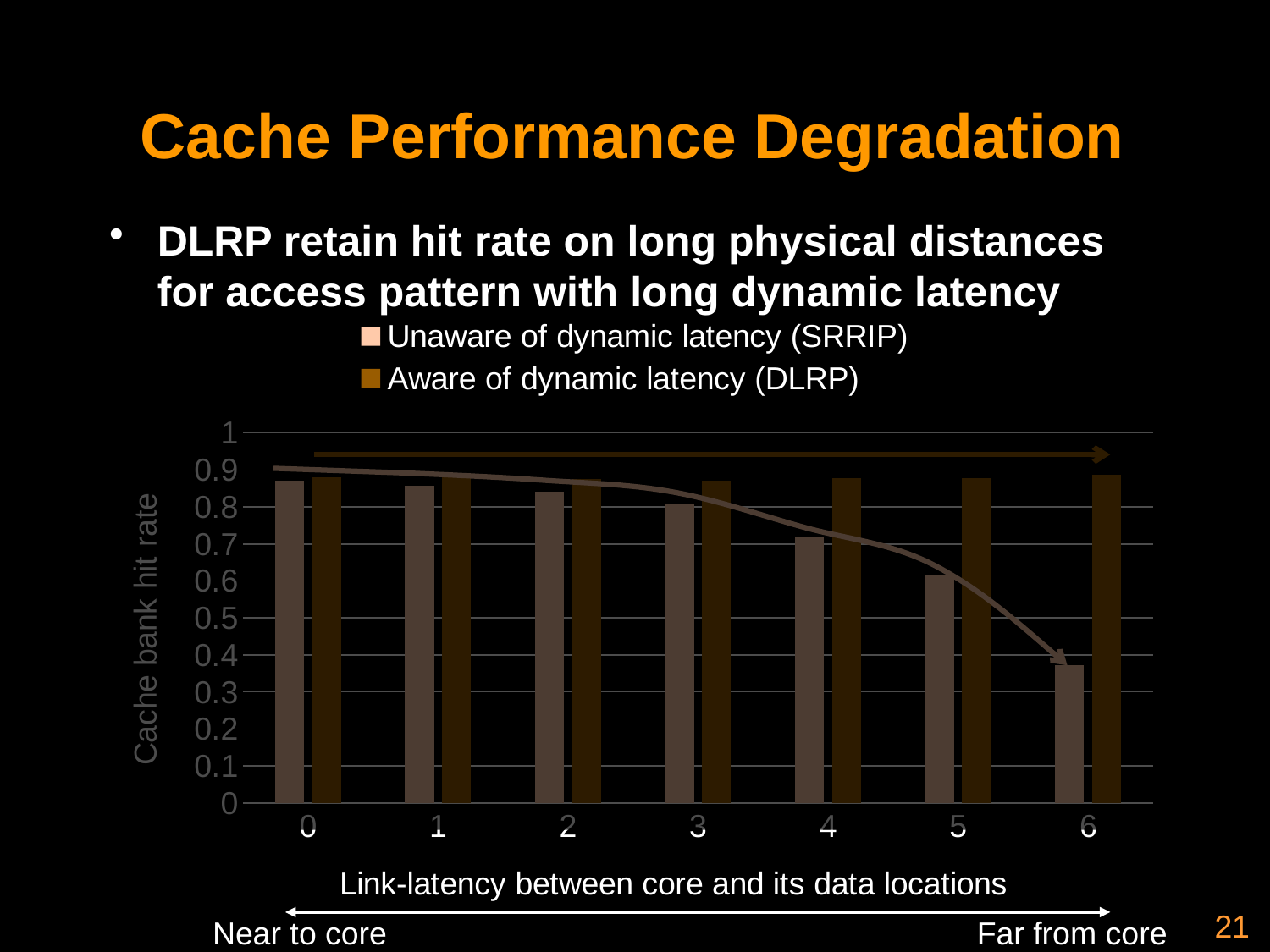
What is the title of the x axis? Link-latency between core and its data locations Is the 'Unaware of dynamic latency (SRRIP)' value at link-latency 6 greater or less than 0.5? less What is the title of the y axis? Cache bank hit rate How many link-latency categories are shown on the x axis? 7 Does the cache bank hit rate for 'Unaware of dynamic latency (SRRIP)' rise or fall as link-latency increases from 0 to 6? fall At which link-latency is the 'Unaware of dynamic latency (SRRIP)' cache bank hit rate lowest? 6 Is the 'Unaware of dynamic latency (SRRIP)' value at link-latency 0 greater or less than 0.8? greater Is the 'Unaware of dynamic latency (SRRIP)' value at link-latency 5 greater or less than 0.7? less At link-latency 6, which series has the higher cache bank hit rate? Aware of dynamic latency (DLRP) How many series does the legend list? 2 What kind of chart is shown on the slide? bar chart